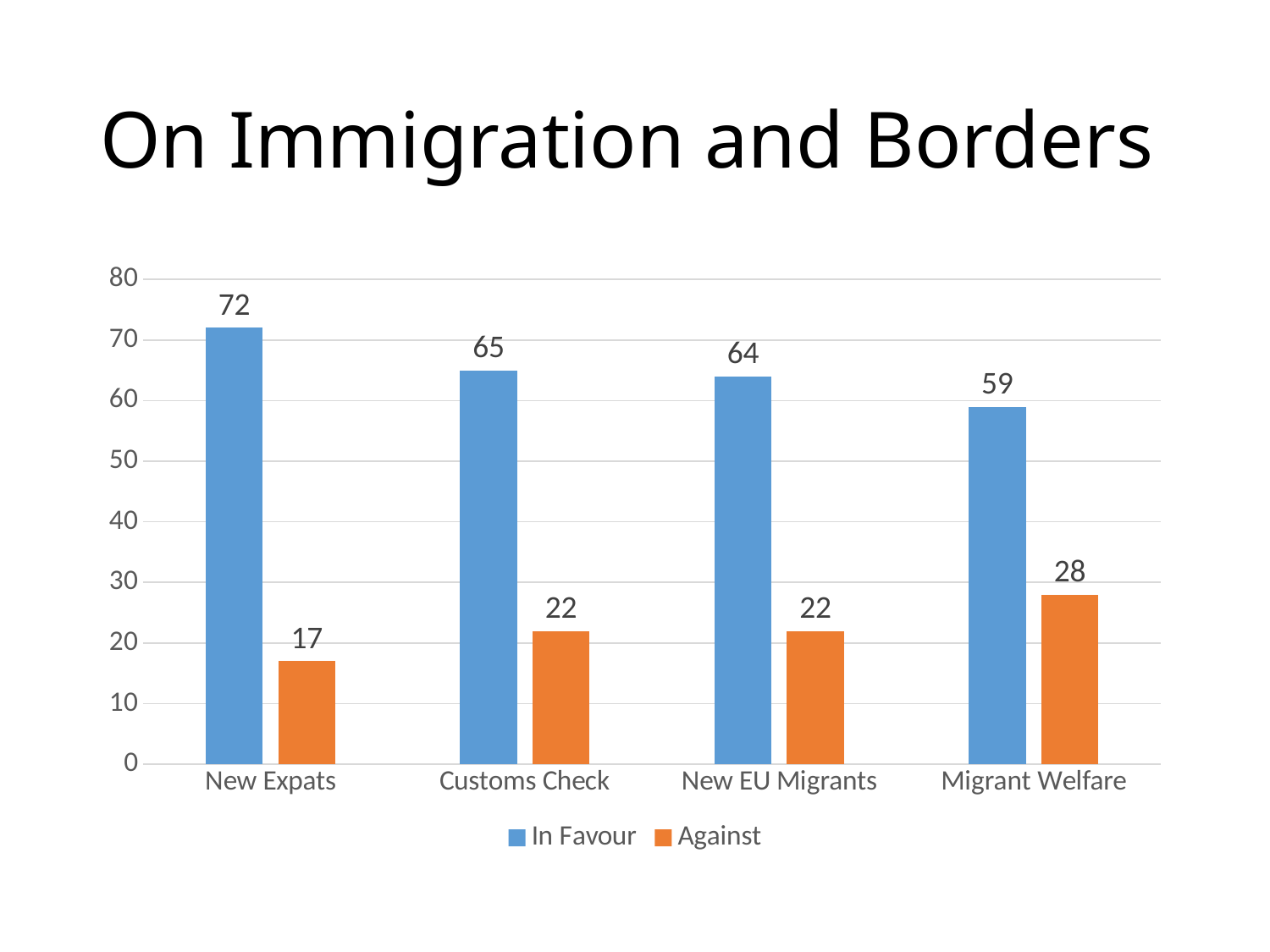
Which category has the lowest Against value? New Expats Is the In Favour value for Migrant Welfare greater or less than 50? greater What is the Against value for Migrant Welfare? 28 What is the In Favour value for Customs Check? 65 What is the difference between the In Favour and Against values for New EU Migrants? 42 How many series does the legend list? 2 What is the title of the slide? On Immigration and Borders What kind of chart is shown on the slide? Bar chart How many categories are shown on the x axis? 4 Which category has the highest In Favour value? New Expats What is the In Favour value for New Expats? 72 Which is larger, the Against value for Migrant Welfare or the Against value for Customs Check? Migrant Welfare